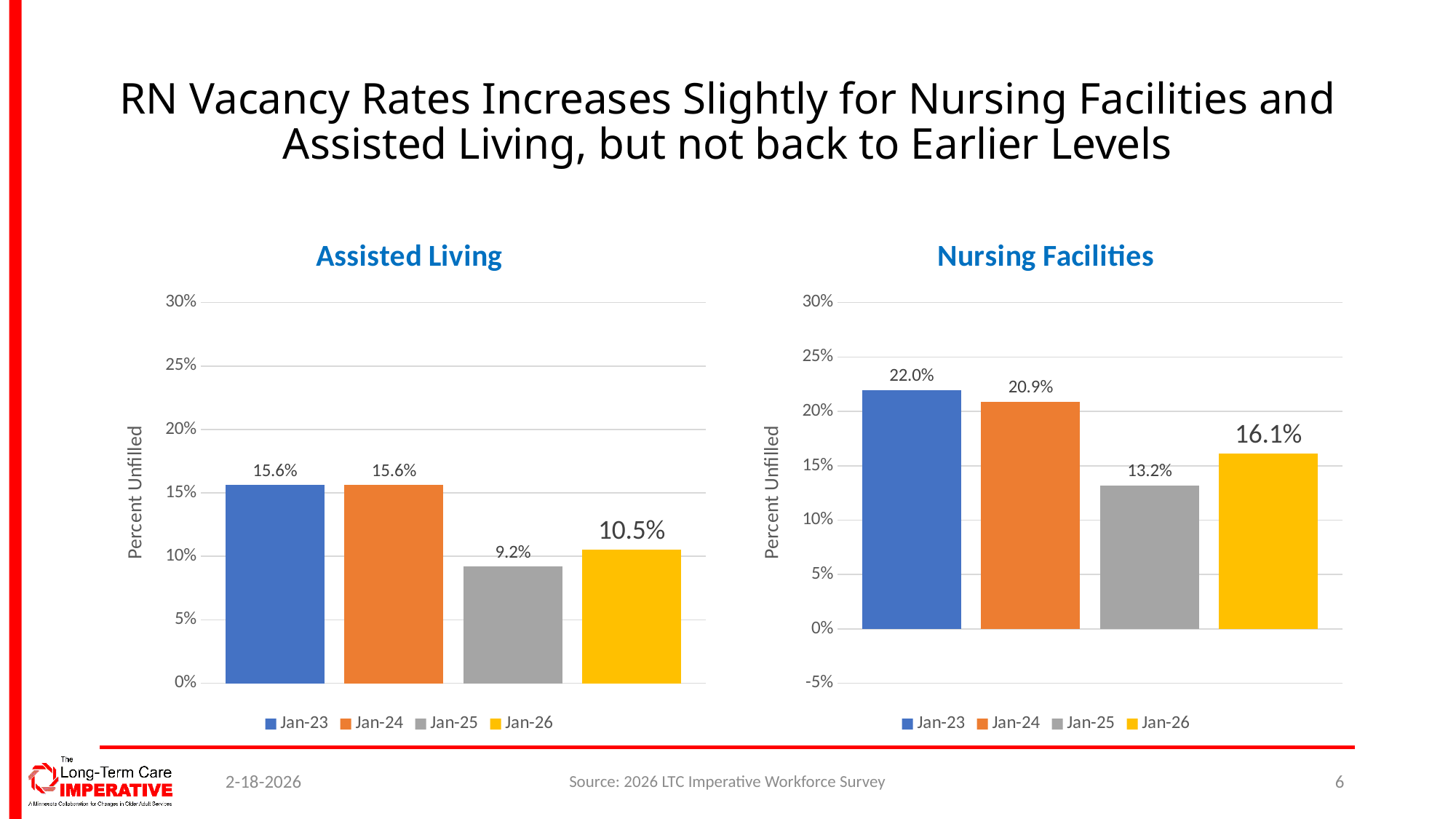
What kind of chart is the Assisted Living chart? bar chart In the Assisted Living chart, what is the difference between the Jan-26 and Jan-25 values? 1.3% In the Nursing Facilities chart, what is the difference between the Jan-24 and Jan-25 values? 7.7% In the Nursing Facilities chart, which series has the highest value? Jan-23 How many series does the legend of the Nursing Facilities chart list? 4 In the Assisted Living chart, which series has the lowest value? Jan-25 In the Nursing Facilities chart, what is the value for Jan-25? 13.2% In the Nursing Facilities chart, what is the value for Jan-23? 22.0% In the Nursing Facilities chart, which is larger, the value for Jan-26 or the value for Jan-25? Jan-26 In the Assisted Living chart, what is the value for Jan-26? 10.5% What is the y-axis label of the Nursing Facilities chart? Percent Unfilled In the Assisted Living chart, is the value for Jan-26 greater or less than 15%? less